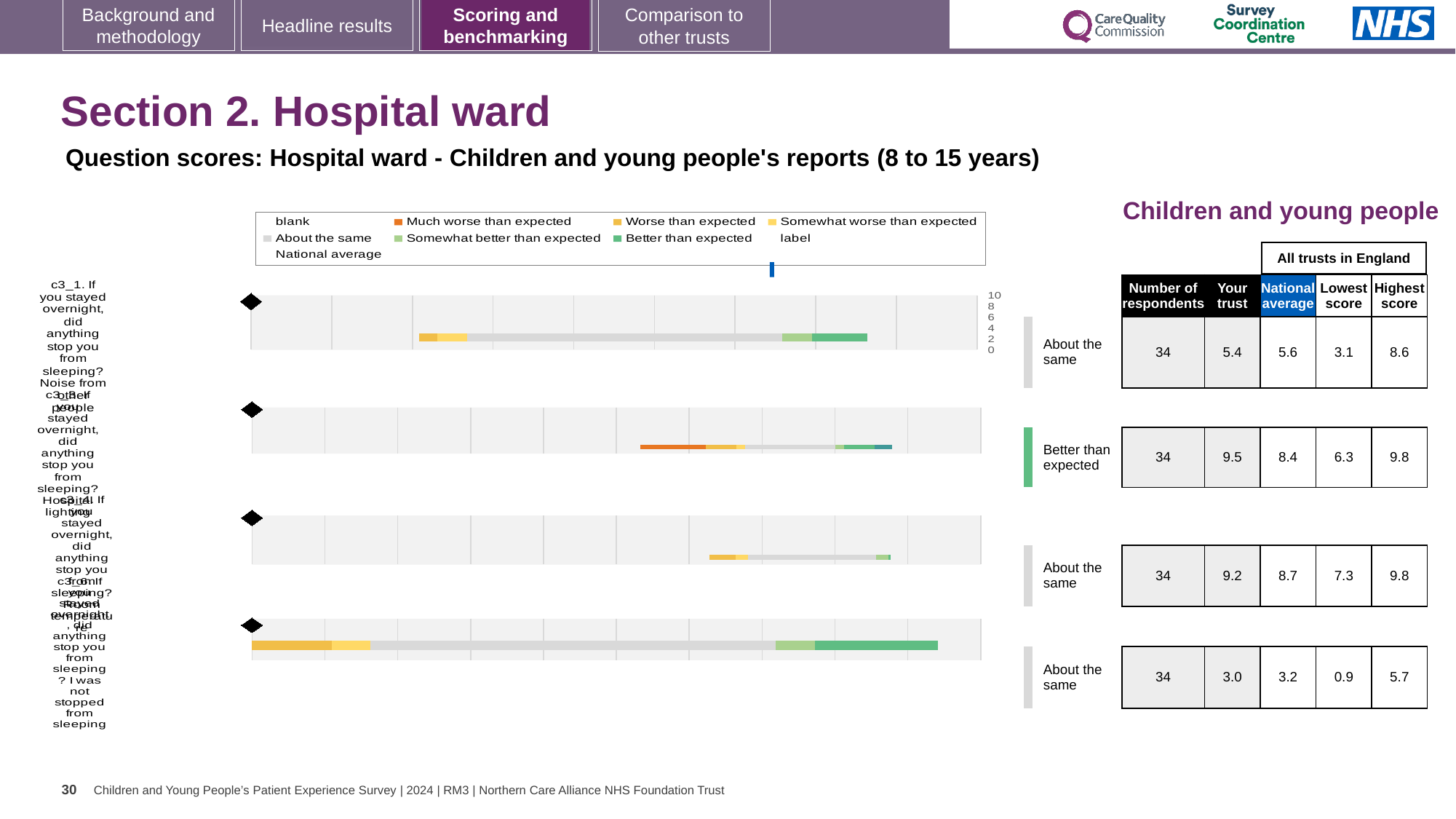
How many entries does the legend above the charts list? 9 Which chart is rated 'Better than expected' in the label beside it? The second chart from the top (c3_3, hospital lighting) For the bottom chart (c3_6, I was not stopped from sleeping), what is the national average shown in the table? 3.2 Which chart's question has the lowest 'Your trust' score in the table? c3_6 (I was not stopped from sleeping), 3.0 Which chart's question has the highest 'Your trust' score in the table? c3_3 (hospital lighting), 9.5 How many question score charts are shown on the slide? 4 For the third chart from the top (c3_4, room temperature), what is the highest score across all trusts in England? 9.8 For the second chart from the top (c3_3, hospital lighting), what is the 'Your trust' score shown in the table? 9.5 What kind of chart is used to show the question scores on this slide? Bar chart For the top chart (c3_1, noise from other people), which is larger: the 'Your trust' score or the national average? National average (5.6 vs 5.4) How many respondents are listed in the table for the third chart from the top (c3_4)? 34 For the second chart from the top (c3_3), what is the difference between the 'Your trust' score and the national average? 1.1